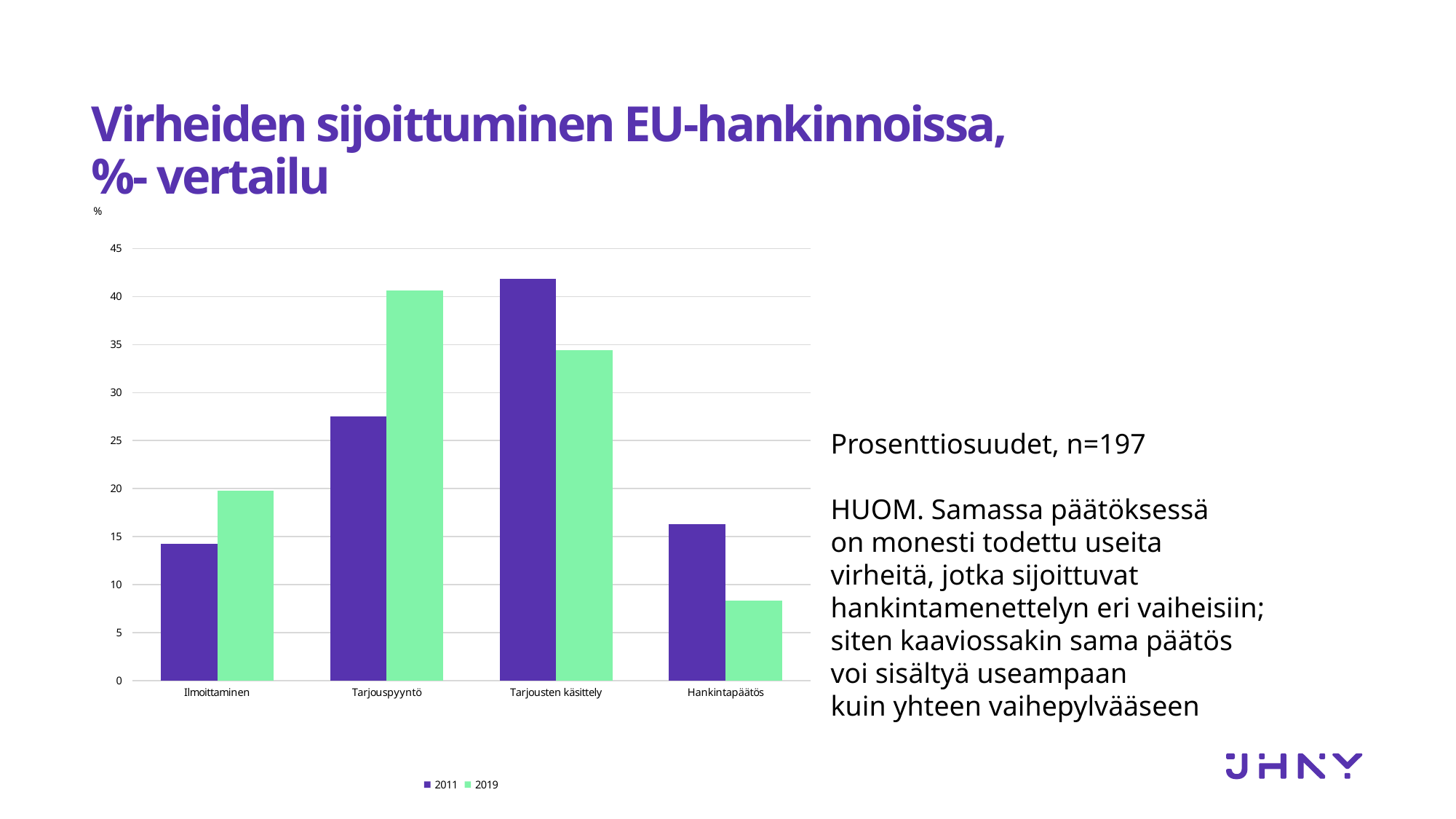
What are the two series named in the chart's legend? 2011 and 2019 For Tarjouspyyntö, which series has the larger value, 2011 or 2019? 2019 What kind of chart is shown on the slide? bar chart How many series does the chart's legend list? 2 How many categories are shown on the x axis of the chart? 4 Which category has the lowest value for the 2019 series? Hankintapäätös For Hankintapäätös, which series has the larger value, 2011 or 2019? 2011 Which category has the highest value for the 2011 series? Tarjousten käsittely Is the 2019 value for Hankintapäätös greater or less than 10? less Is the 2011 value for Tarjouspyyntö greater or less than 30? less Is the 2011 value for Tarjousten käsittely greater or less than 40? greater Which category has the highest value for the 2019 series? Tarjouspyyntö